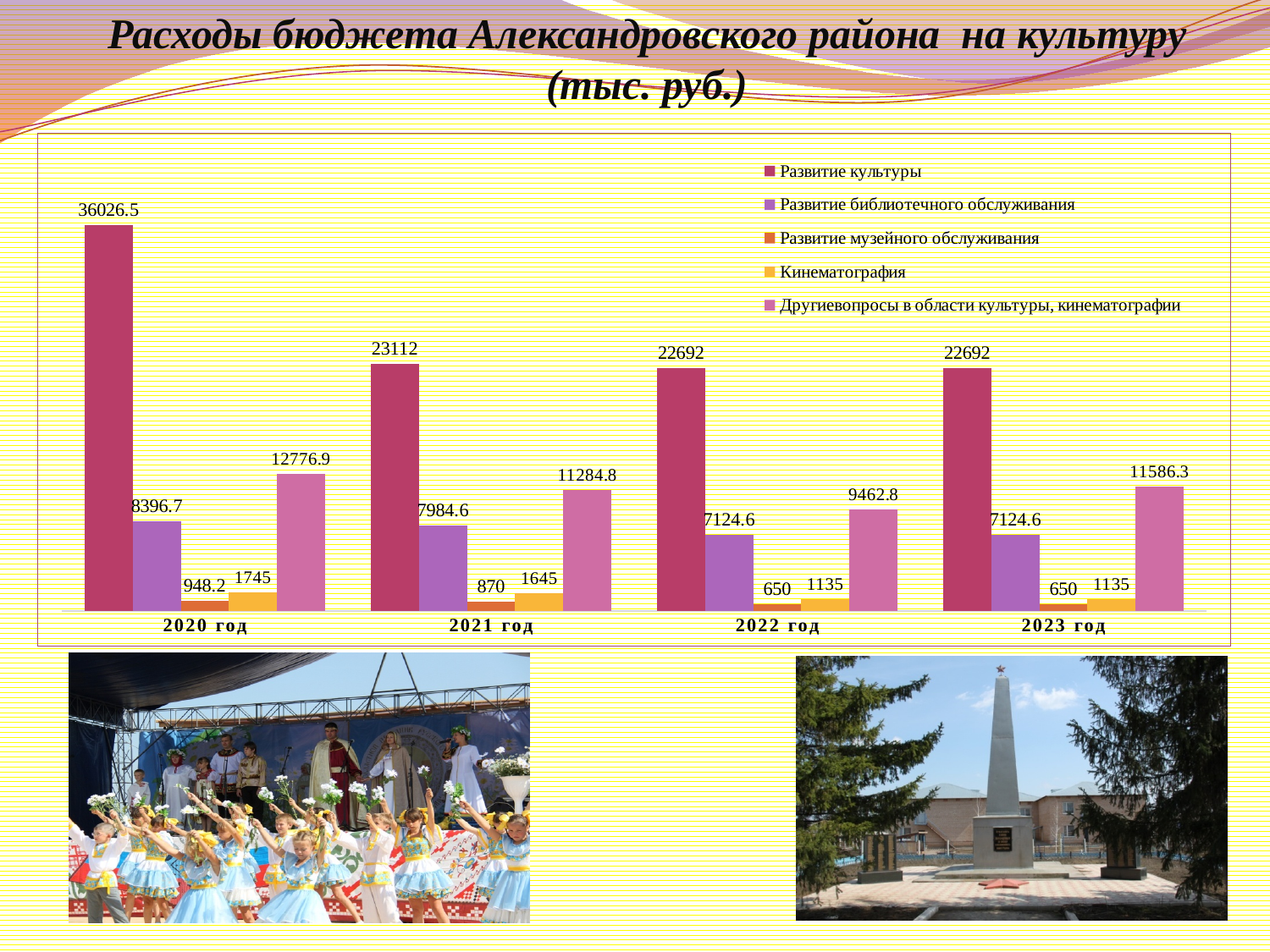
What is the value for Развитие библиотечного обслуживания in 2021 год? 7984.6 Does the value for Развитие музейного обслуживания rise or fall from 2020 год to 2022 год? Fall What is the value for Другие вопросы в области культуры, кинематографии in 2023 год? 11586.3 How many years are shown on the x axis? 4 What is the difference between the Развитие культуры values for 2020 год and 2021 год? 12914.5 What is the value for Кинематография in 2022 год? 1135 How many series does the legend list? 5 Which series has the lowest value in 2021 год? Развитие музейного обслуживания In which year is the value for Развитие культуры highest? 2020 год What is the value for Развитие культуры in 2020 год? 36026.5 What kind of chart is shown on the slide? Bar chart Which is larger: Другие вопросы в области культуры, кинематографии in 2022 год or in 2023 год? 2023 год